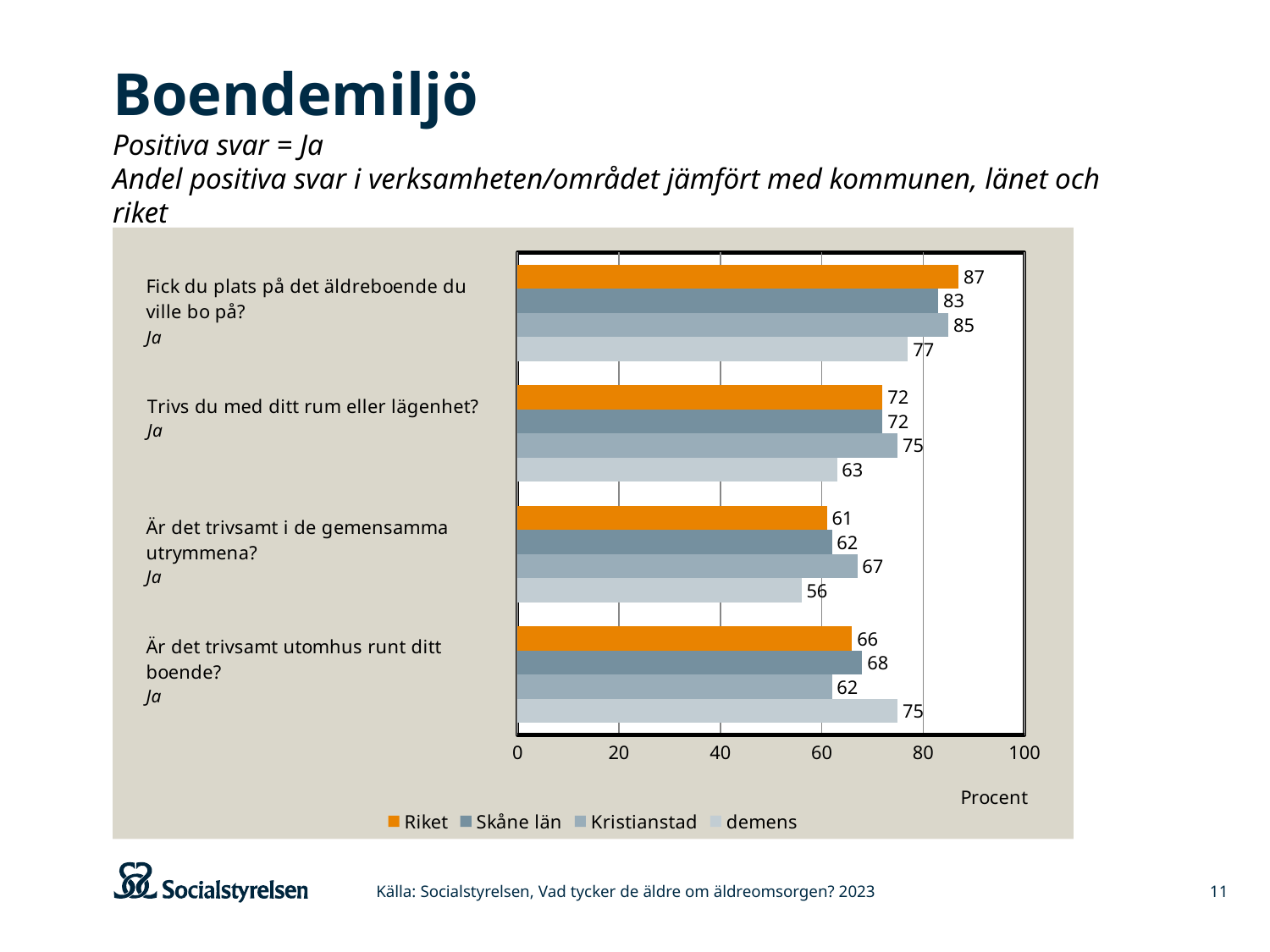
What is the value for demens for "Trivs du med ditt rum eller lägenhet?"? 63 What is the difference between Riket and demens for "Fick du plats på det äldreboende du ville bo på?"? 10 What is the value for Kristianstad for "Är det trivsamt i de gemensamma utrymmena?"? 67 How many series does the legend list? 4 What is the value for Riket for "Fick du plats på det äldreboende du ville bo på?"? 87 Which series has the lowest value for "Är det trivsamt i de gemensamma utrymmena?"? demens Which is larger for "Är det trivsamt utomhus runt ditt boende?": Skåne län or Kristianstad? Skåne län How many question categories are plotted on the chart? 4 What kind of chart is shown on the slide? Bar chart Which series has the highest value for "Är det trivsamt utomhus runt ditt boende?"? demens What unit label is shown below the x axis? Procent Is the value for Kristianstad for "Trivs du med ditt rum eller lägenhet?" greater or less than 60? greater